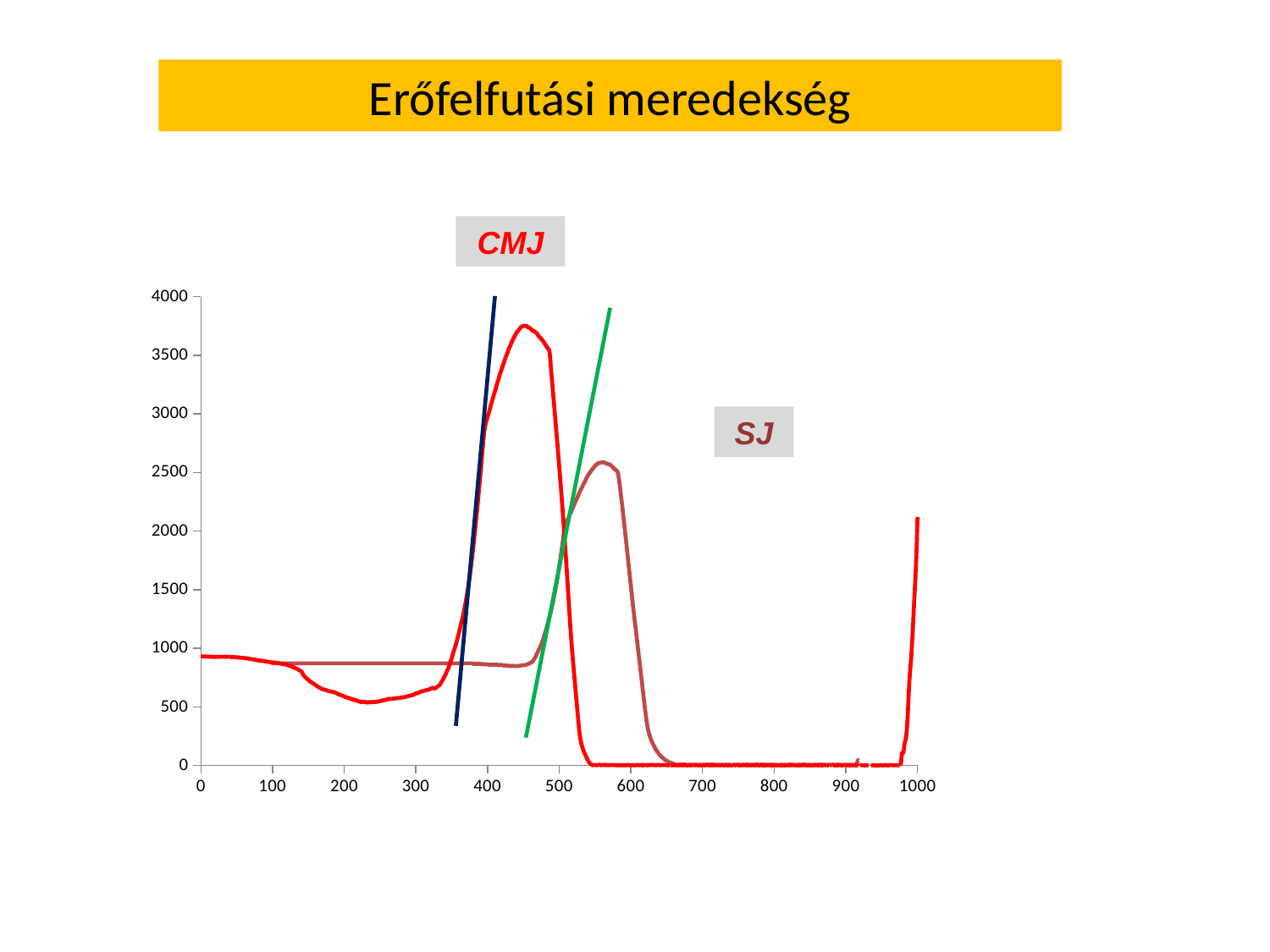
Does the SJ curve rise or fall between x = 600 and x = 650? fall Is the value of the CMJ curve at x = 800 greater or less than 500? less Which curve reaches its peak earlier along the x axis, CMJ or SJ? CMJ Is the value of the CMJ curve at x = 0 greater or less than 500? greater Is the peak value of the SJ curve greater or less than 2000? greater What kind of chart is shown on the slide? line chart Which curve reaches the higher peak, CMJ or SJ? CMJ How many labelled curves (CMJ and SJ) are plotted on the chart? 2 What is the title of the slide containing the chart? Erőfelfutási meredekség What is the highest value shown on the y axis? 4000